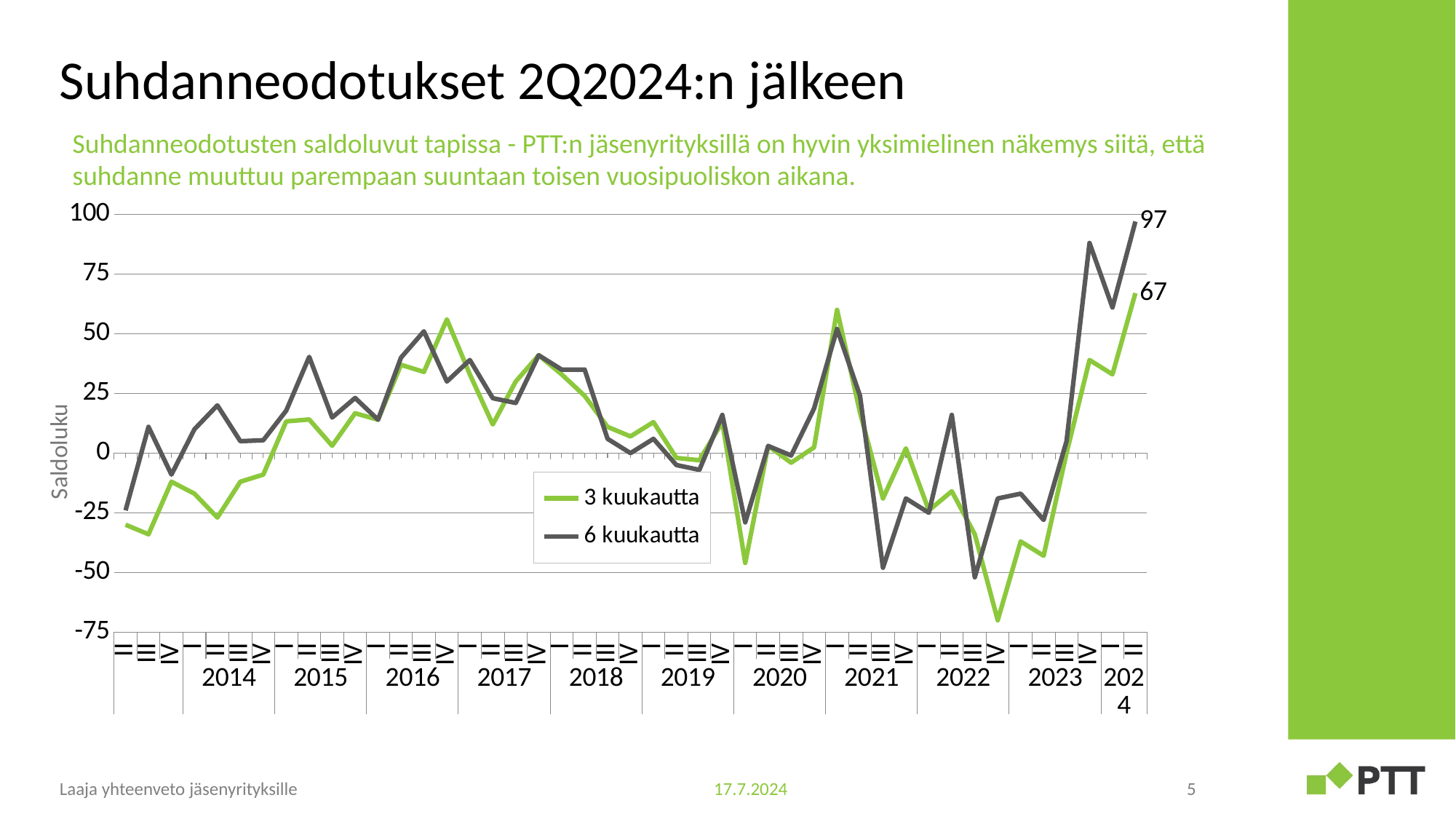
What is the final labelled value of the '3 kuukautta' series? 67 Do both series rise or fall from 2023 to 2024? rise At the last data point, which series has the larger value, '3 kuukautta' or '6 kuukautta'? 6 kuukautta Is the lowest point of the '3 kuukautta' series (in 2022) greater or less than -50? less In which year does the '3 kuukautta' series reach its lowest point? 2022 What is the difference between the final labelled values of the '6 kuukautta' and '3 kuukautta' series? 30 What kind of chart is shown on the slide? line chart What is the final labelled value of the '6 kuukautta' series? 97 How many series does the legend list? 2 What colour is the '3 kuukautta' line? green What is the title of the vertical axis? Saldoluku Is the final value of the '6 kuukautta' series greater or less than 75? greater